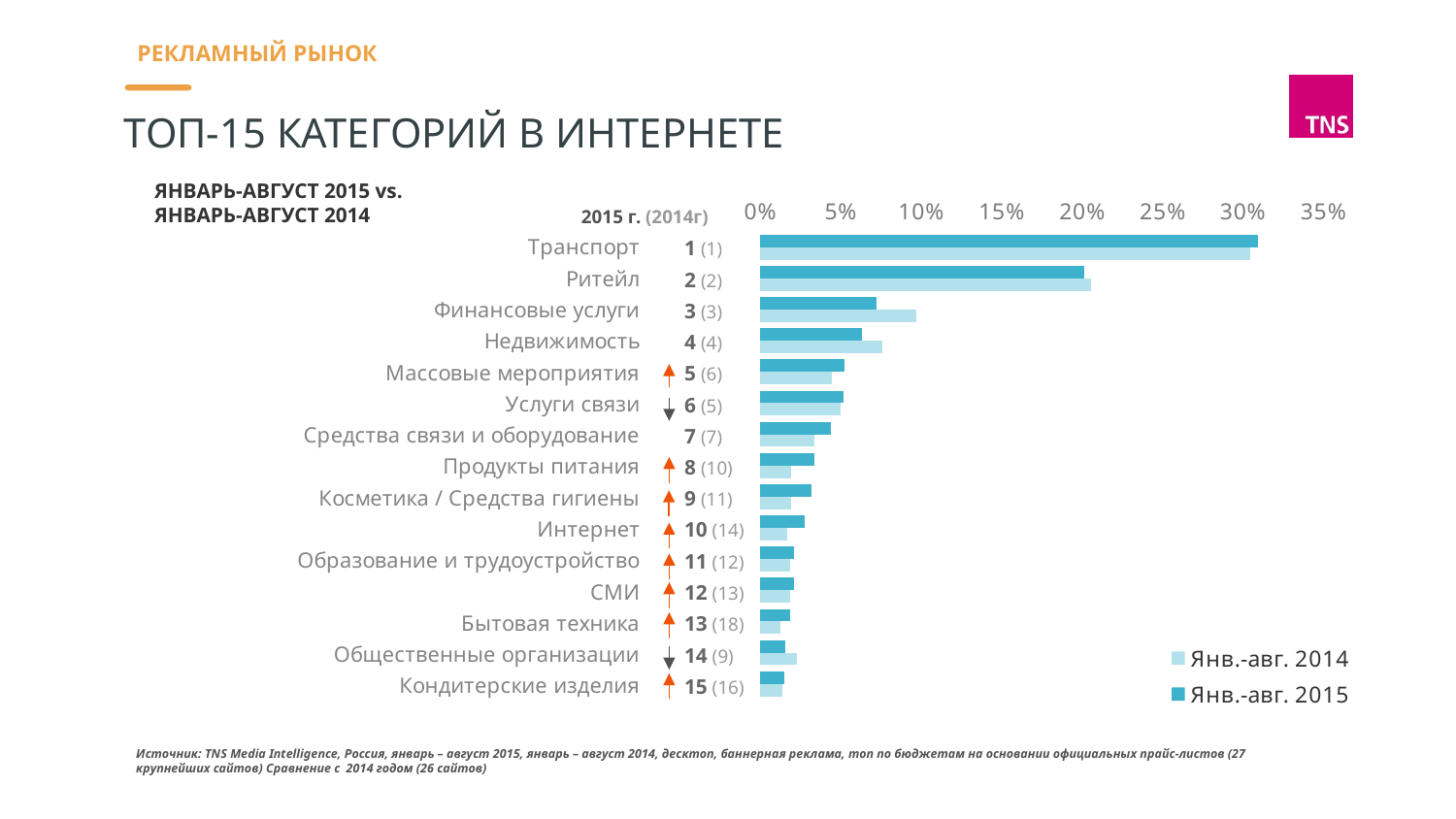
Is the Янв.-авг. 2015 value for Транспорт greater or less than 25%? greater How many series does the legend list? 2 Which is larger for Интернет: the Янв.-авг. 2014 value or the Янв.-авг. 2015 value? Янв.-авг. 2015 What are the two series named in the legend? Янв.-авг. 2014 and Янв.-авг. 2015 Is the Янв.-авг. 2015 value for Продукты питания greater or less than 5%? less What was the 2014 rank of Интернет, as shown in parentheses next to the category? 14 Is the Янв.-авг. 2015 value for Финансовые услуги greater or less than 10%? less Which category has the highest value in the chart? Транспорт How many categories are plotted in the chart? 15 What kind of chart is shown on the slide? Bar chart Which is larger for Финансовые услуги: the Янв.-авг. 2014 value or the Янв.-авг. 2015 value? Янв.-авг. 2014